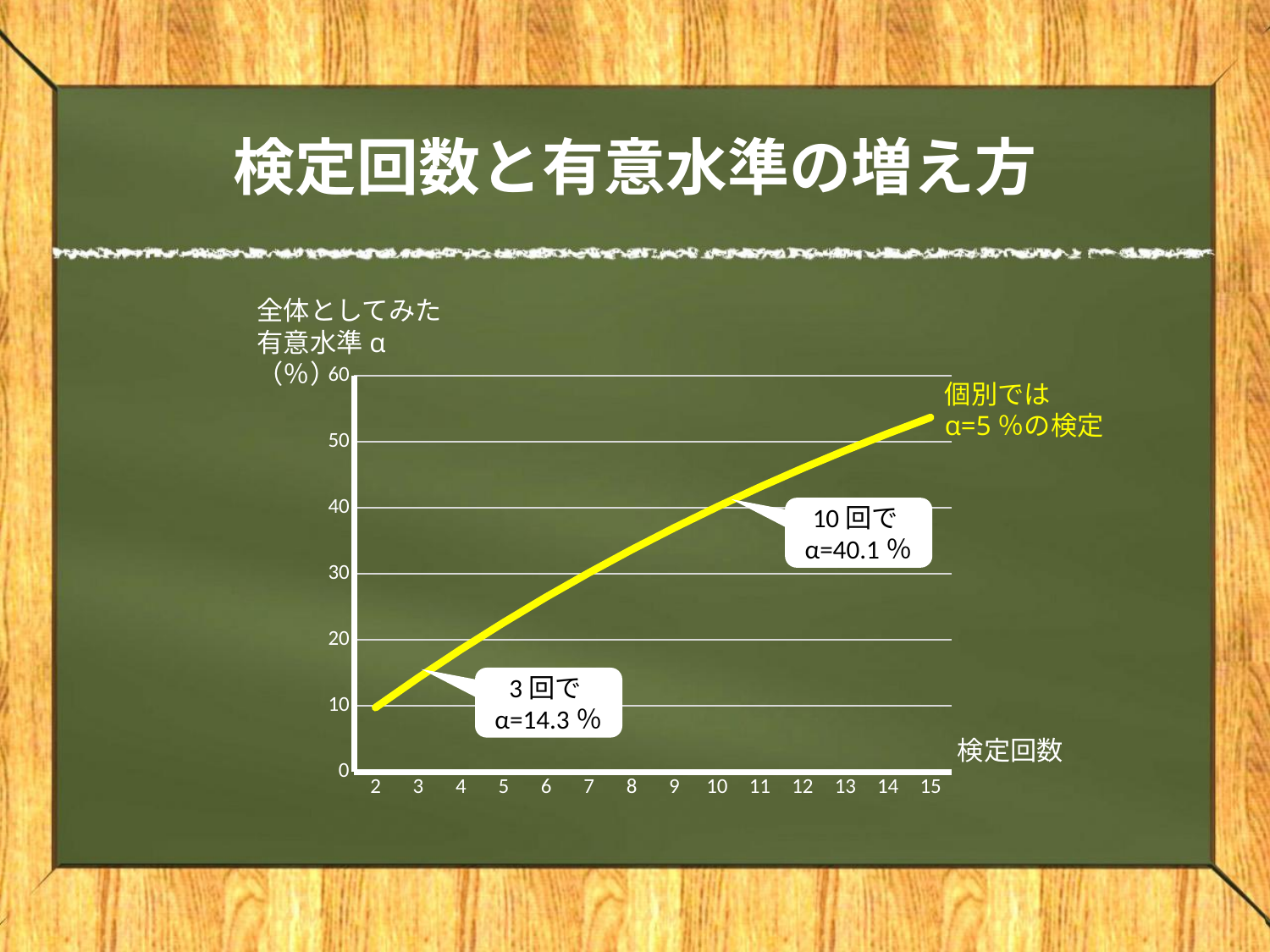
Is the value at 15 tests greater or less than 50? greater Is the value at 8 tests greater or less than 30? greater What is the value of α when the number of tests is 3? 14.3 % Is the value at 6 tests greater or less than 20? greater Does the plotted value rise or fall as the number of tests increases along the x axis? Rises What kind of chart is shown on the slide? Line chart At which number of tests is the plotted value highest? 15 What is the difference between the α value at 10 tests and at 3 tests? 25.8 % What is the title of the slide? 検定回数と有意水準の増え方 What is the value of α when the number of tests is 10? 40.1 % At which number of tests is the plotted value lowest? 2 Which is larger, the α value at 10 tests or at 3 tests? 10 tests